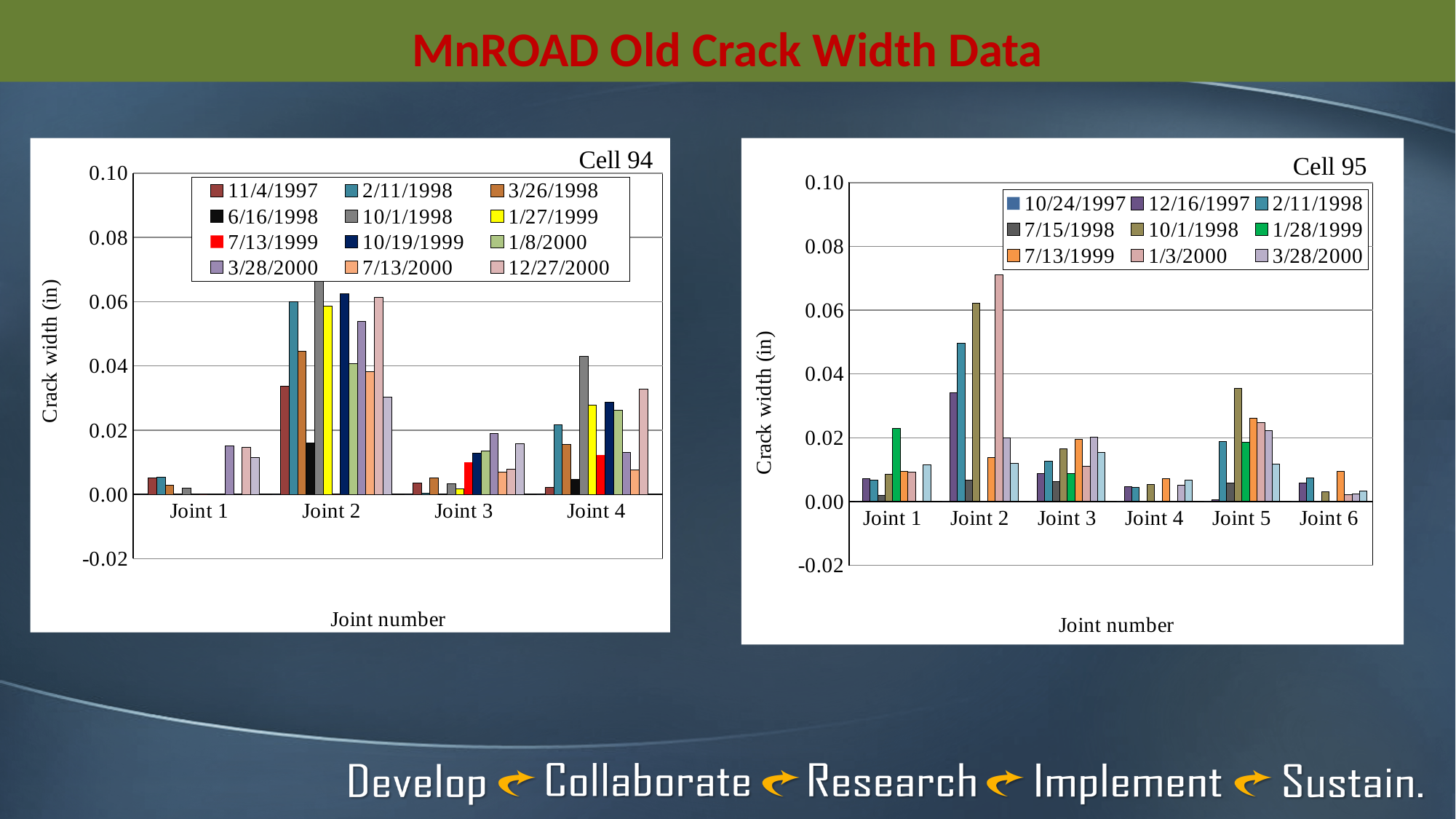
What is the y-axis title of the Cell 95 chart? Crack width (in) How many series does the legend of the Cell 95 chart list? 9 How many joints are shown on the x axis of the Cell 95 chart? 6 In the Cell 94 chart, is the value for 10/1/1998 at Joint 2 greater or less than 0.06? greater In the Cell 94 chart, which joint has the tallest bar? Joint 2 In the Cell 95 chart, is the value for 1/3/2000 at Joint 2 greater or less than 0.06? greater How many series does the legend of the Cell 94 chart list? 12 How many joints are shown on the x axis of the Cell 94 chart? 4 In the Cell 95 chart, is the 2/11/1998 value larger at Joint 2 or at Joint 5? Joint 2 In the Cell 95 chart, is the value for 2/11/1998 at Joint 5 greater or less than 0.04? less In the Cell 95 chart, which series has the tallest bar at Joint 2? 1/3/2000 What type of chart is the Cell 94 chart? bar chart